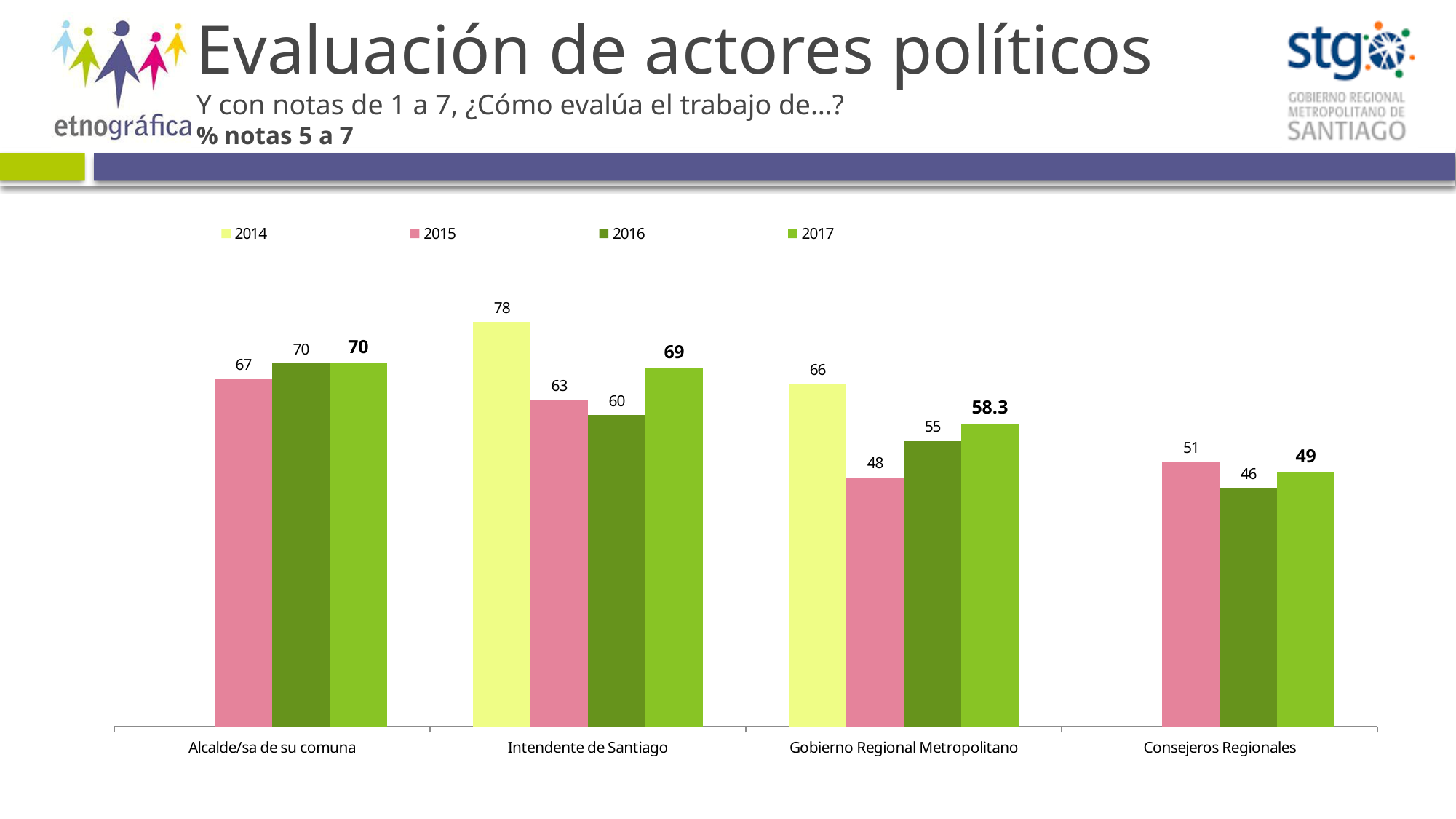
What is the 2016 value for Consejeros Regionales? 46 What is the difference between the 2014 and 2015 values for Intendente de Santiago? 15 Which series is shown in pink in the legend? 2015 How many series does the legend list? 4 Which category has the lowest 2017 value? Consejeros Regionales What is the 2015 value for Gobierno Regional Metropolitano? 48 How many categories are shown on the x axis? 4 Which category has the highest 2014 value? Intendente de Santiago Which is larger for Alcalde/sa de su comuna: the 2015 value or the 2017 value? 2017 What is the 2017 value for Intendente de Santiago? 69 What kind of chart is shown on the slide? bar chart What is the 2017 value for Gobierno Regional Metropolitano? 58.3